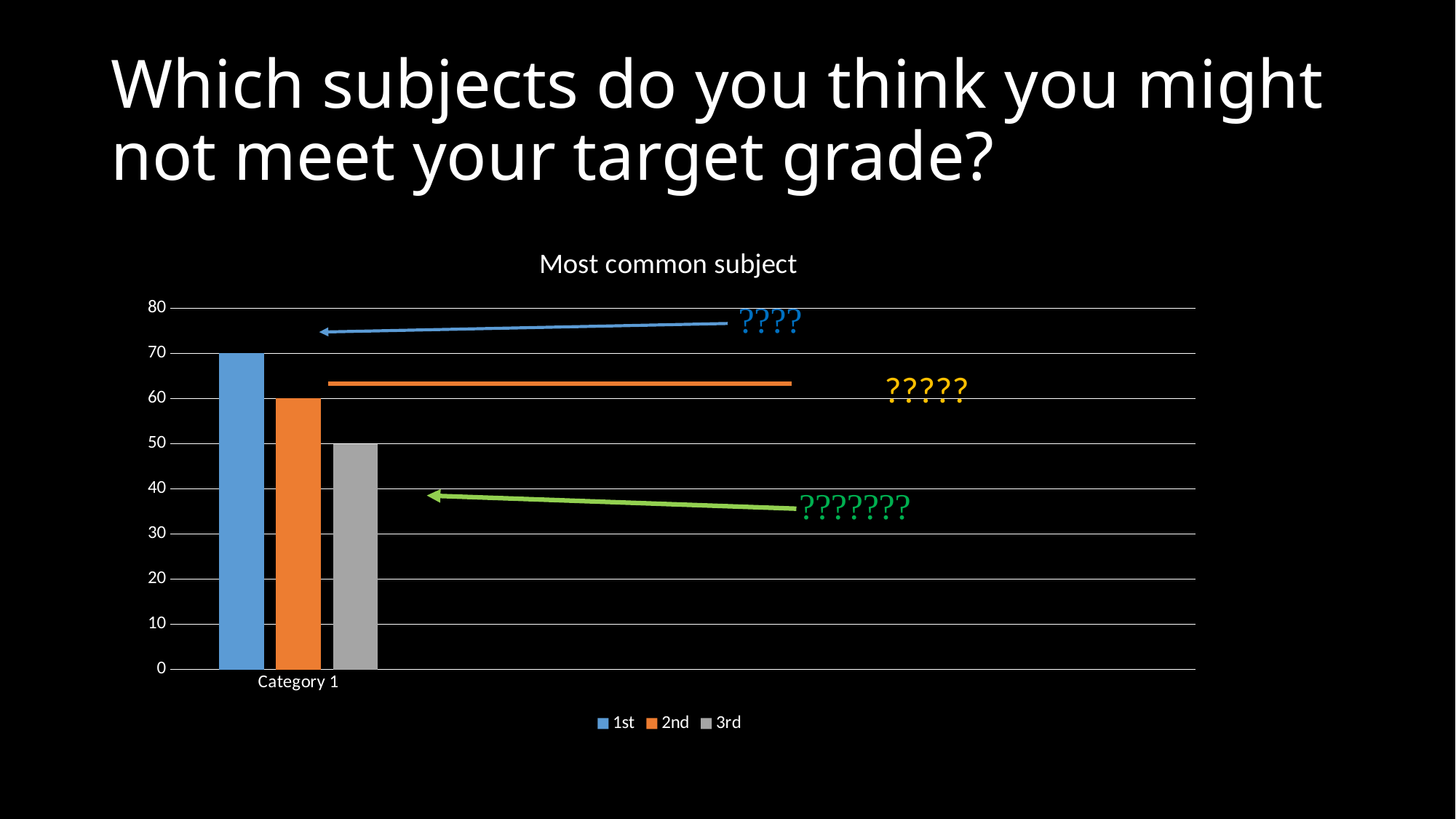
What is the value of the 2nd series for Category 1? 60 What kind of chart is shown on the slide? bar chart Which series has the highest value for Category 1? 1st Which is larger for Category 1, the 2nd series or the 3rd series? 2nd Which colour represents the 2nd series in the chart legend? orange How many categories are shown on the x axis of the chart? 1 Which series has the lowest value for Category 1? 3rd What is the difference between the 1st and 3rd series values for Category 1? 20 What is the title of the chart? Most common subject What is the value of the 3rd series for Category 1? 50 How many series does the chart legend list? 3 What is the value of the 1st series for Category 1? 70